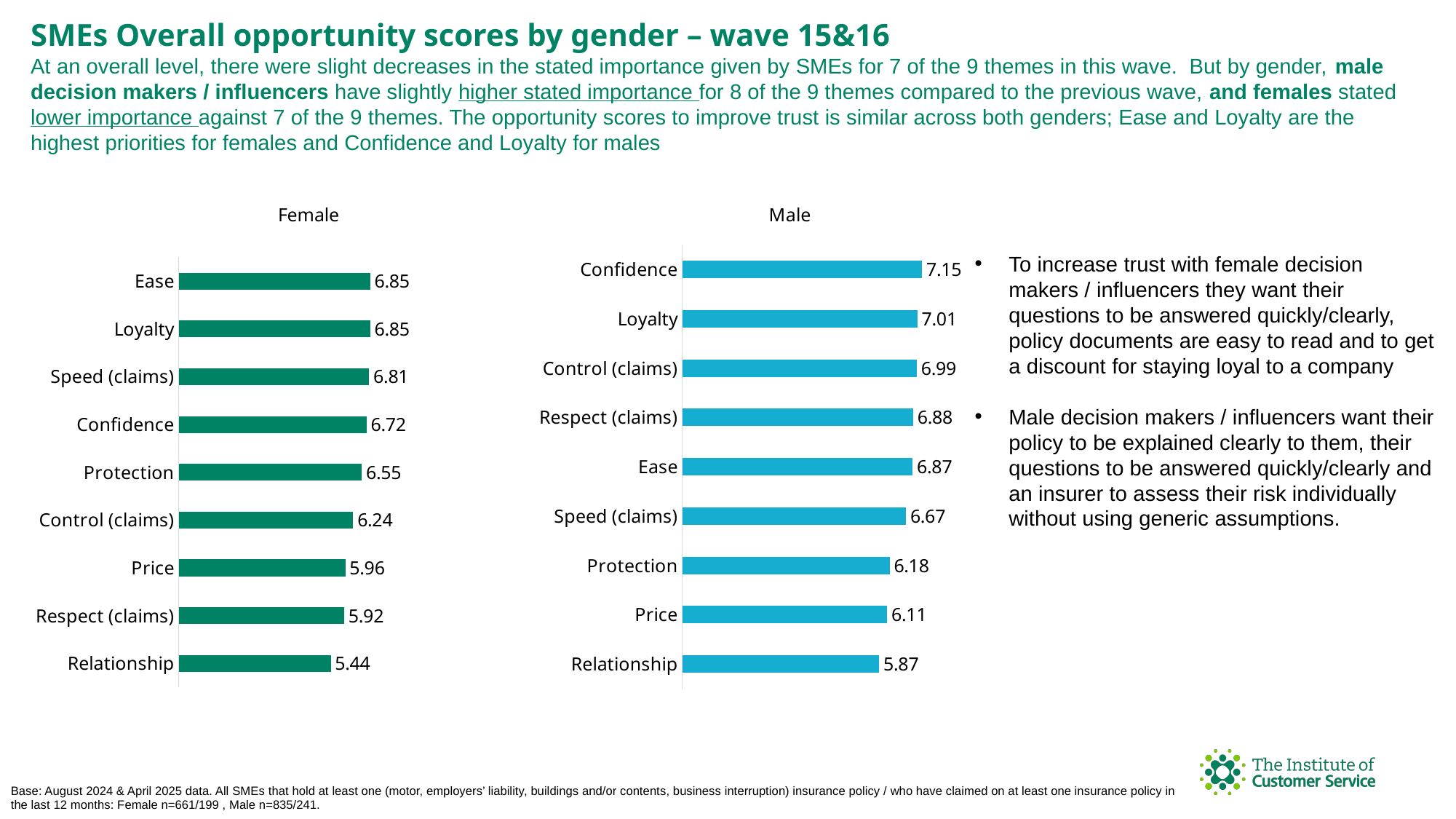
In the Female chart, which is larger, Confidence or Control (claims)? Confidence In the Female chart, what is the value for Protection? 6.55 What kind of chart is the Male chart? Bar chart In the Female chart, which category has the lowest value? Relationship In the Female chart, what is the difference between Ease and Price? 0.89 How many categories are shown in the Female chart? 9 In the Male chart, which category has the highest value? Confidence In the Male chart, which is larger, Protection or Speed (claims)? Speed (claims) In the Male chart, what is the difference between Confidence and Relationship? 1.28 What is the title of the chart on the left? Female In the Female chart, what is the value for Respect (claims)? 5.92 In the Male chart, what is the value for Control (claims)? 6.99